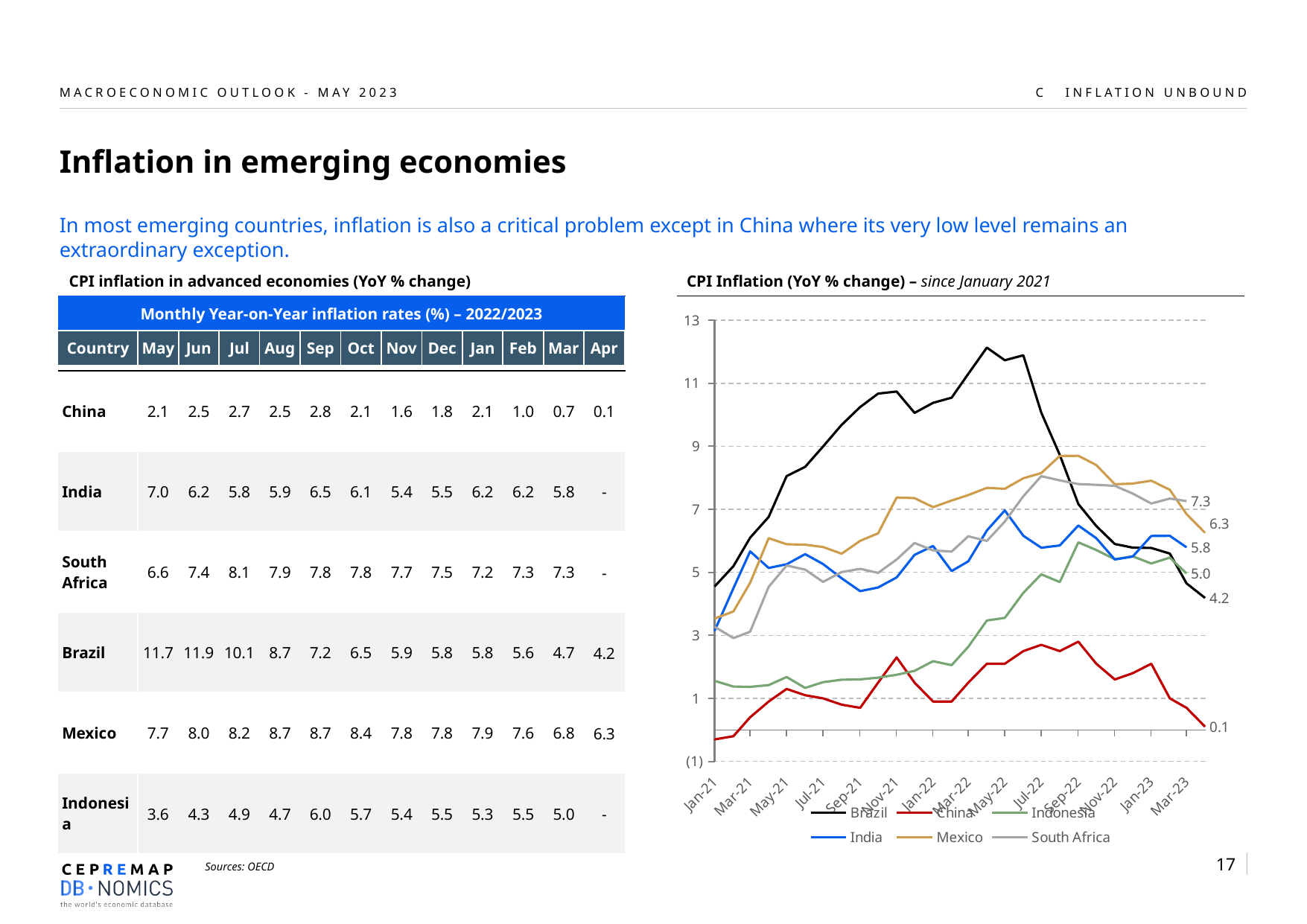
What type of chart is the 'CPI Inflation (YoY % change) – since January 2021' chart? line chart In the CPI Inflation line chart, is Brazil's peak value greater or less than 11? greater In the CPI Inflation line chart, what is the difference between the final labelled values for South Africa (7.3) and Mexico (6.3)? 1.0 In the CPI Inflation line chart, what is the final labelled value for Brazil? 4.2 How many series does the legend of the CPI Inflation line chart list? 6 In the CPI Inflation line chart, what is the final labelled value for China? 0.1 In the CPI Inflation line chart, which country has the highest value at the end of the series? South Africa In the CPI Inflation line chart, which is larger at the end of the series: India or Indonesia? India In the CPI Inflation line chart, does the Brazil line rise or fall between mid-2022 and March 2023? fall In the CPI Inflation line chart, what is the final labelled value for Mexico? 6.3 Which colour is used for the China line in the CPI Inflation line chart? red In the CPI Inflation line chart, which country has the lowest value at the end of the series? China